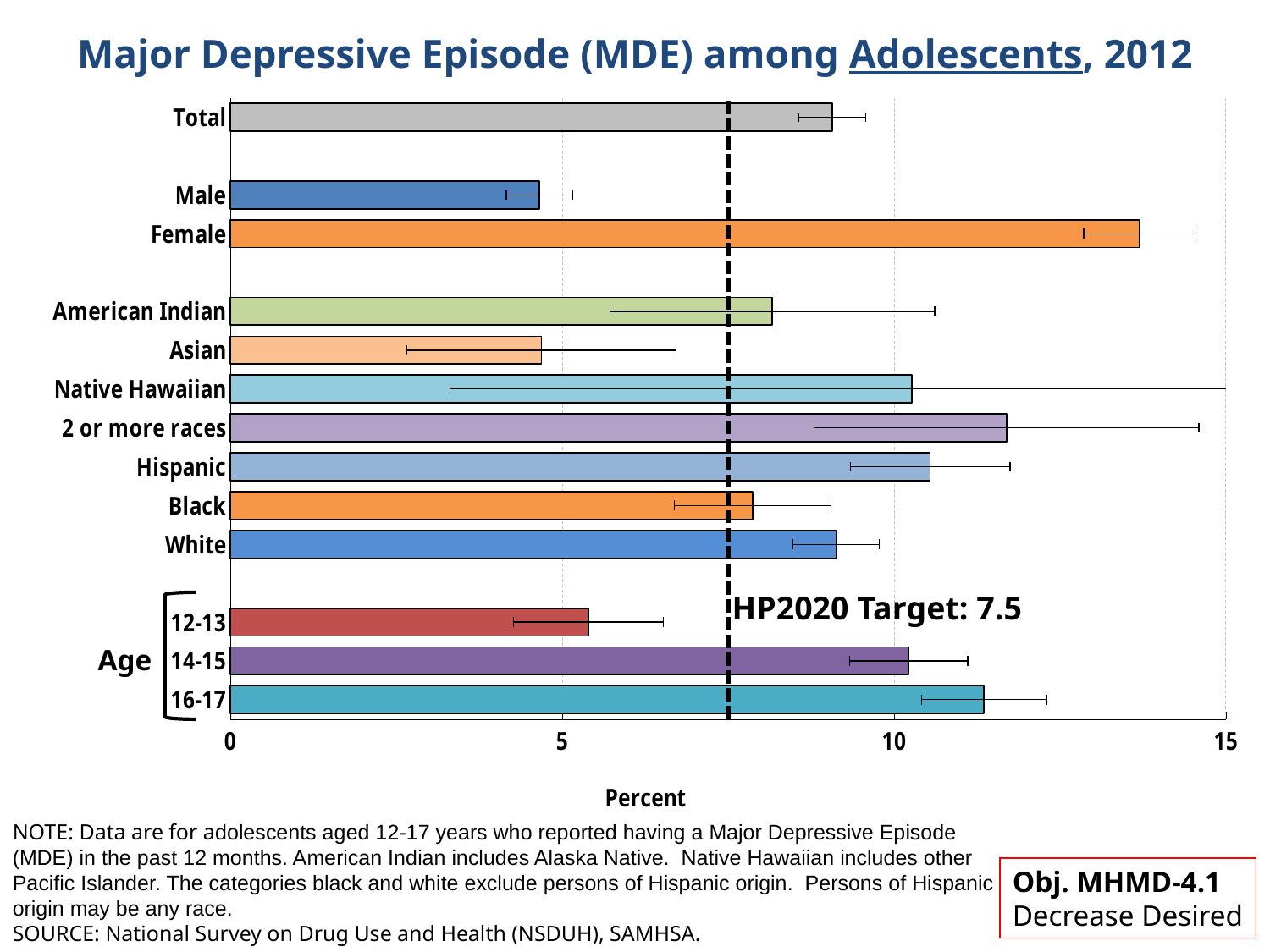
Is the value for Asian greater or less than 5? less How many bars (categories) are plotted in the chart? 13 Is the value for the 16-17 age group greater or less than 10? greater What is the HP2020 Target value marked by the dashed line on the chart? 7.5 Which category has the highest percentage of adolescents with a Major Depressive Episode? Female Is the value for Male greater or less than 5? less Which is larger, the value for Female or the value for Male? Female What kind of chart is shown on the slide? bar chart Which is larger, the value for the 12-13 age group or the 16-17 age group? 16-17